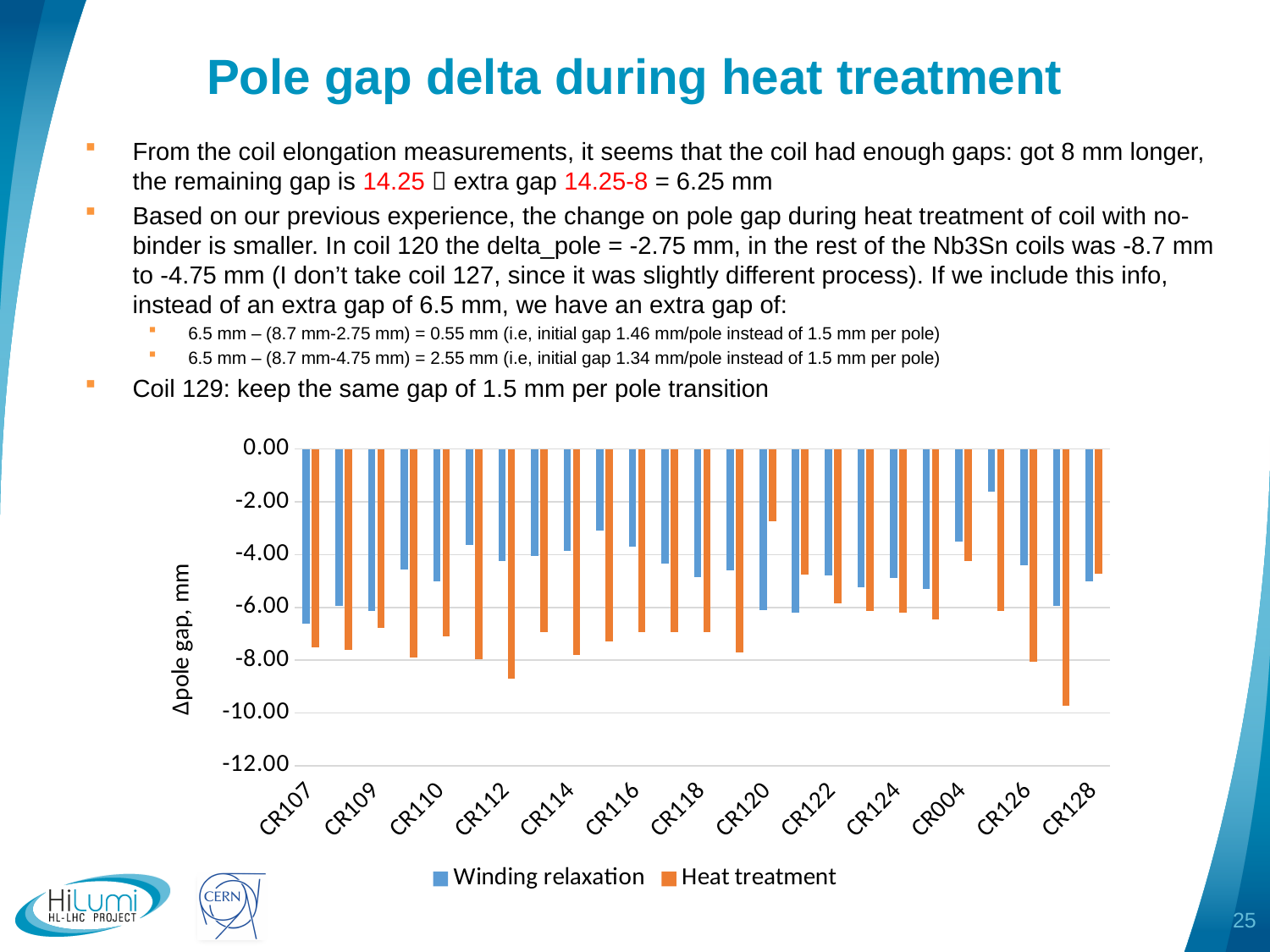
Is the Winding relaxation value for CR128 greater or less than -4.00? less For CR120, which series has the value closer to zero, Winding relaxation or Heat treatment? Heat treatment What is the label of the vertical axis of the chart? Δpole gap, mm For CR112, which series has the more negative value, Winding relaxation or Heat treatment? Heat treatment Which series contains the most negative bar on the chart? Heat treatment Is the Heat treatment value for CR004 greater or less than -6.00? greater What type of chart is shown on the slide? bar chart What are the two series named in the chart legend? Winding relaxation and Heat treatment How many series does the chart legend list? 2 Is the Heat treatment value for CR107 greater or less than -6.00? less